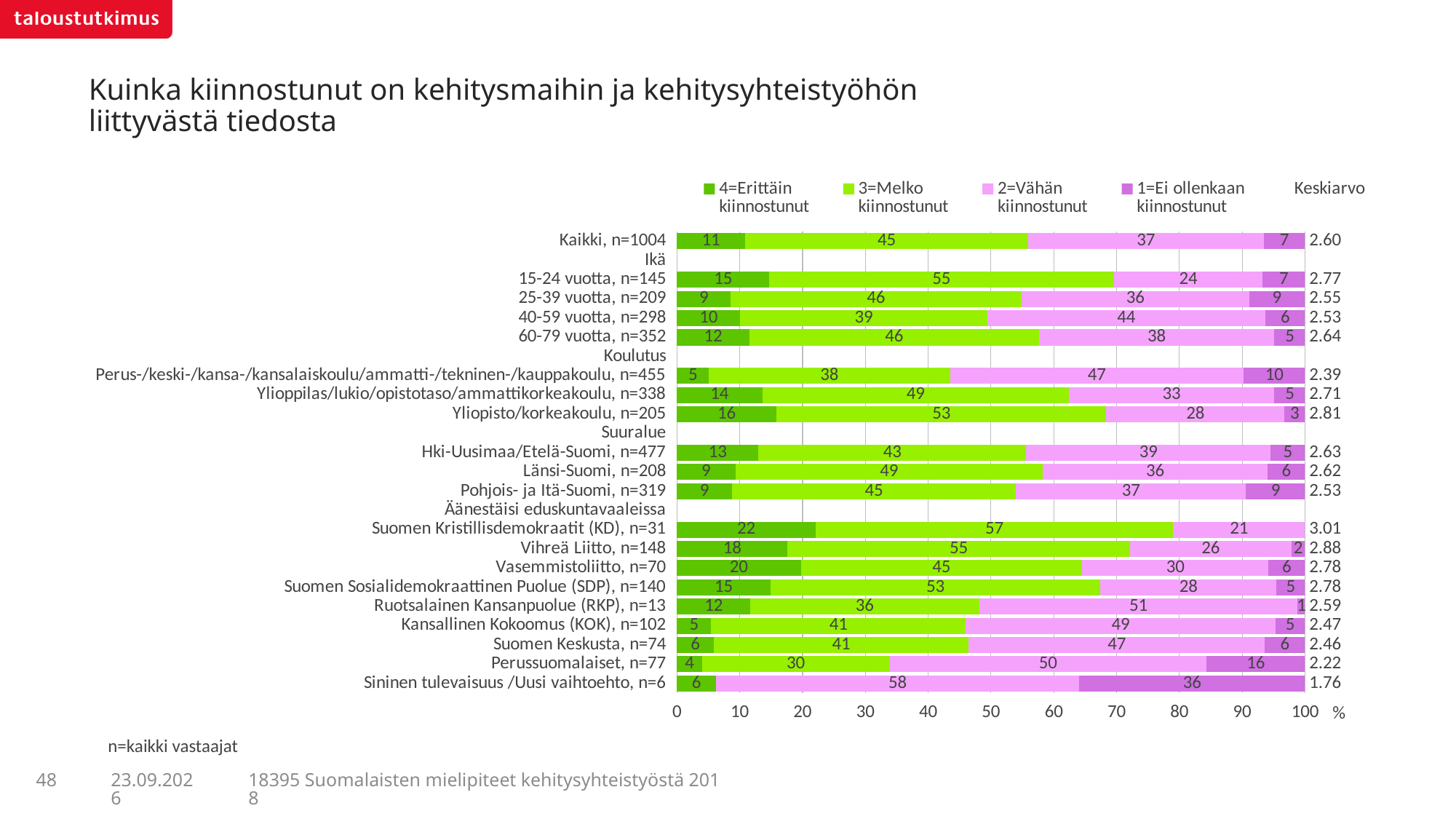
Which has a larger 2=Vähän kiinnostunut percentage: Ruotsalainen Kansanpuolue (RKP), n=13 or Kansallinen Kokoomus (KOK), n=102? Ruotsalainen Kansanpuolue (RKP), n=13 What percentage of the Kaikki, n=1004 group is 3=Melko kiinnostunut? 45 What is the combined percentage of 4=Erittäin kiinnostunut and 3=Melko kiinnostunut for Vihreä Liitto, n=148? 73 Which group has the lowest Keskiarvo value? Sininen tulevaisuus /Uusi vaihtoehto, n=6 How many groups (bars) are plotted in the chart? 20 How many series does the legend list (excluding the Keskiarvo column)? 4 What is the Keskiarvo value for Yliopisto/korkeakoulu, n=205? 2.81 What is the Keskiarvo value for 40-59 vuotta, n=298? 2.53 What is the difference in the 4=Erittäin kiinnostunut percentage between 15-24 vuotta, n=145 and 25-39 vuotta, n=209? 6 What percentage of Perussuomalaiset, n=77 is 1=Ei ollenkaan kiinnostunut? 16 Which group has the highest Keskiarvo value? Suomen Kristillisdemokraatit (KD), n=31 What kind of chart is shown on the slide? Stacked bar chart